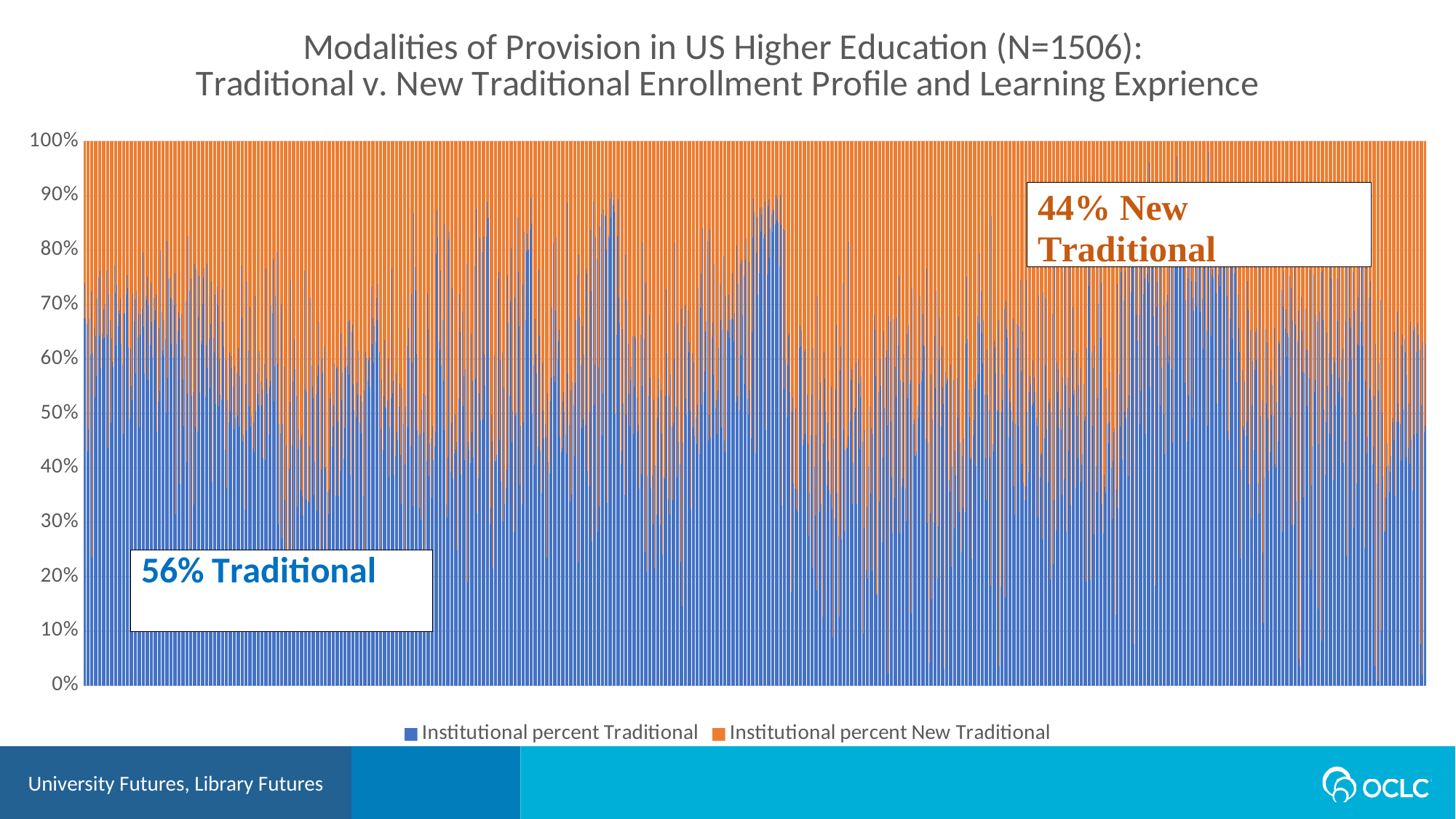
What is the difference between the overall Traditional share and the overall New Traditional share shown in the annotations? 12 percentage points What are the two series named in the legend? Institutional percent Traditional; Institutional percent New Traditional What sample size (N) is stated in the chart title? 1506 What kind of chart is shown on the slide? bar chart According to the annotation on the chart, what overall percentage is Traditional? 56% What does each stacked bar total, as shown by the top of the y axis? 100% Which overall share is larger, Traditional or New Traditional? Traditional According to the annotation on the chart, what overall percentage is New Traditional? 44% Which colour represents Institutional percent New Traditional? orange How many series does the legend list? 2